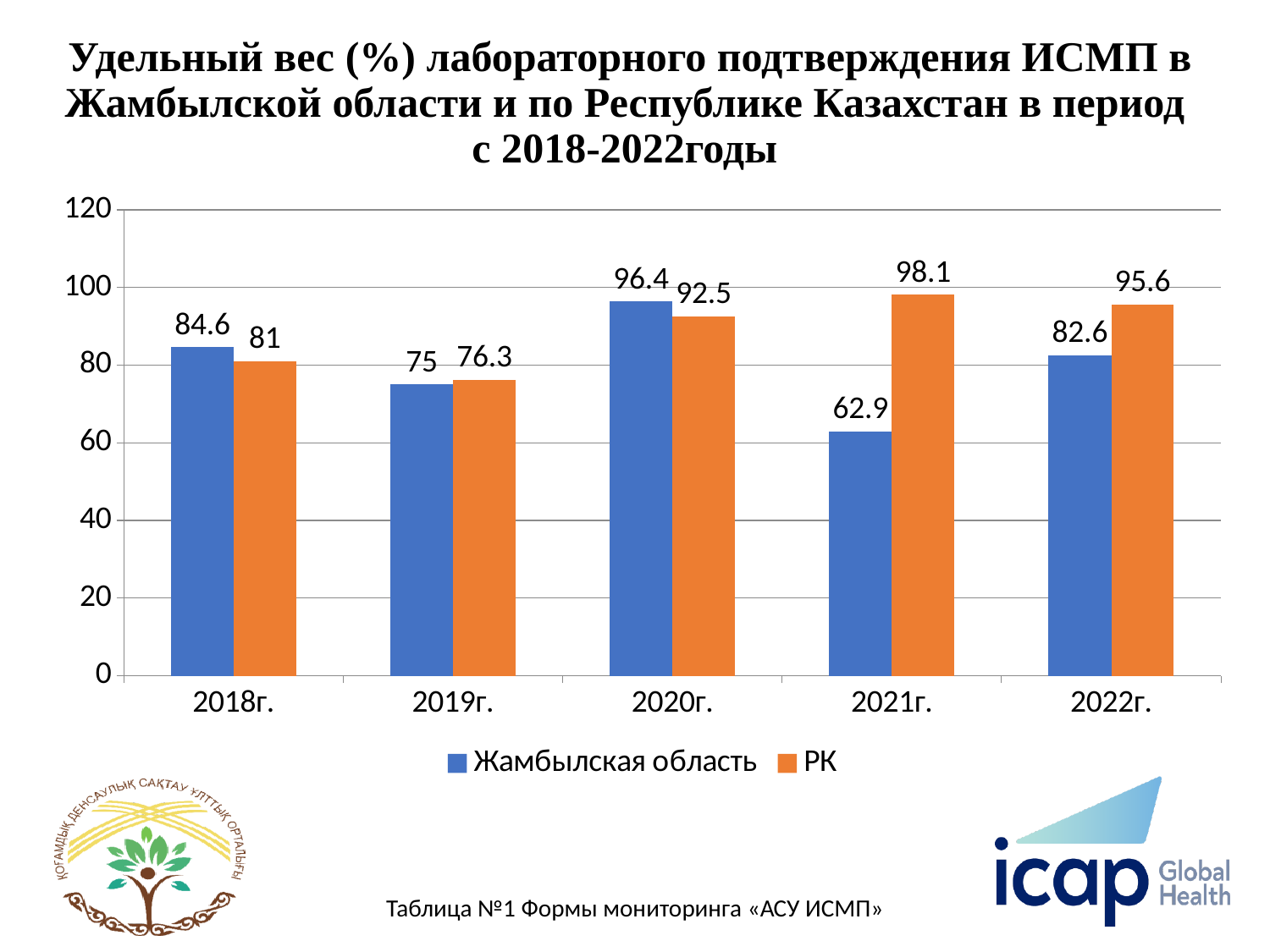
How many years are shown on the x axis? 5 How many series does the legend list? 2 What is the value for Жамбылская область in 2019г.? 75 What kind of chart is shown on the slide? bar chart What is the value for РК in 2021г.? 98.1 In which year is the value for Жамбылская область the lowest? 2021г. Which is larger in 2020г., the value for Жамбылская область or for РК? Жамбылская область Is the value for Жамбылская область in 2021г. greater or less than 80? less What is the difference between the РК value and the Жамбылская область value in 2021г.? 35.2 What is the value for Жамбылская область in 2020г.? 96.4 In which year is the value for РК the highest? 2021г. What is the difference between the Жамбылская область value and the РК value in 2018г.? 3.6